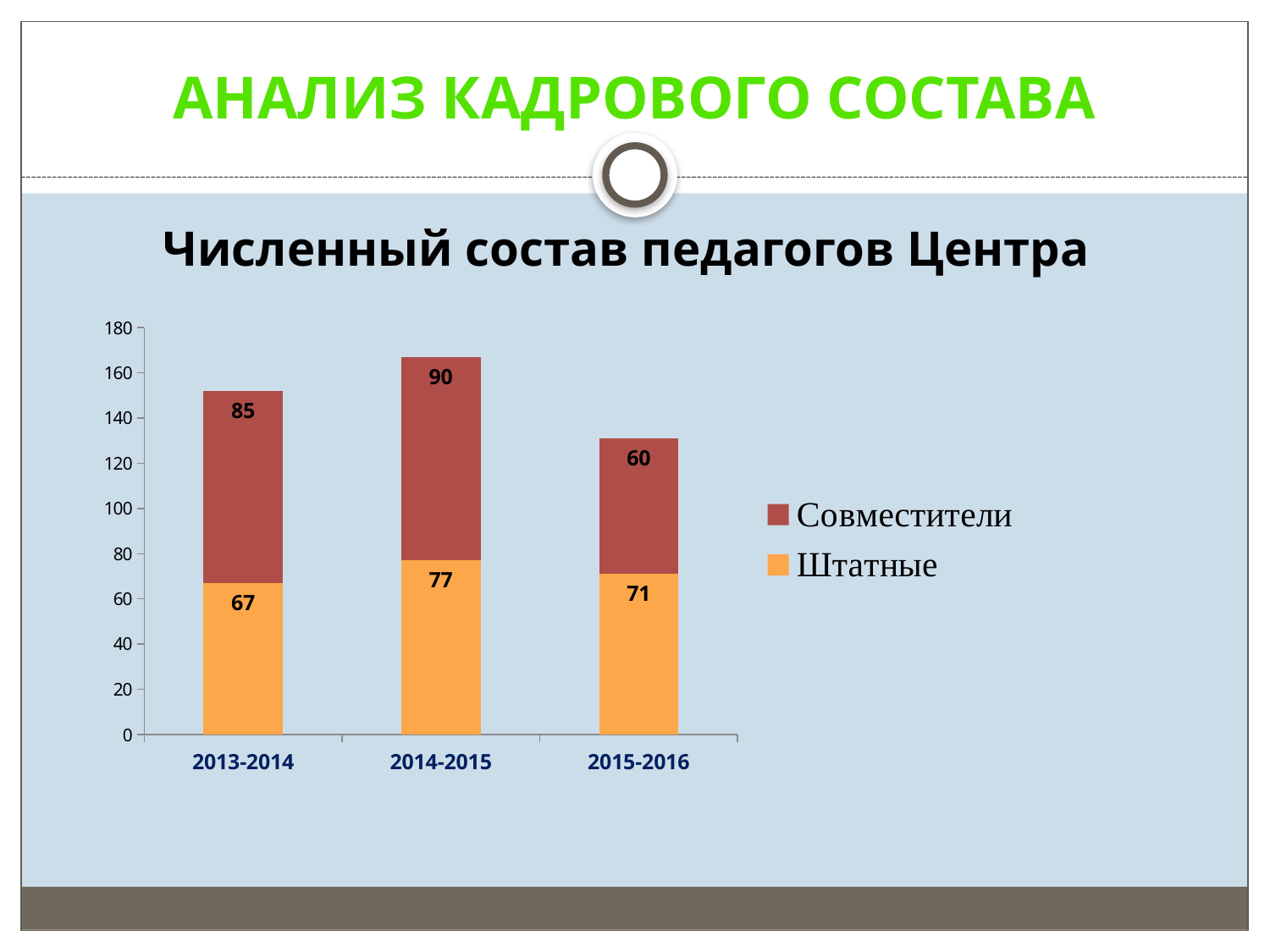
How many series does the legend list? 2 What is the difference between Совместители in 2014-2015 and 2015-2016? 30 What is the value for Совместители in 2013-2014? 85 Which year has the highest value for Совместители? 2014-2015 Which is larger: Штатные in 2015-2016 or Штатные in 2013-2014? Штатные in 2015-2016 What is the total of the stacked bar for 2015-2016? 131 Which year has the lowest value for Штатные? 2013-2014 What is the value for Совместители in 2015-2016? 60 What kind of chart is shown? Stacked bar chart What is the total of the stacked bar for 2014-2015? 167 How many years are shown on the x axis? 3 What is the value for Штатные in 2014-2015? 77